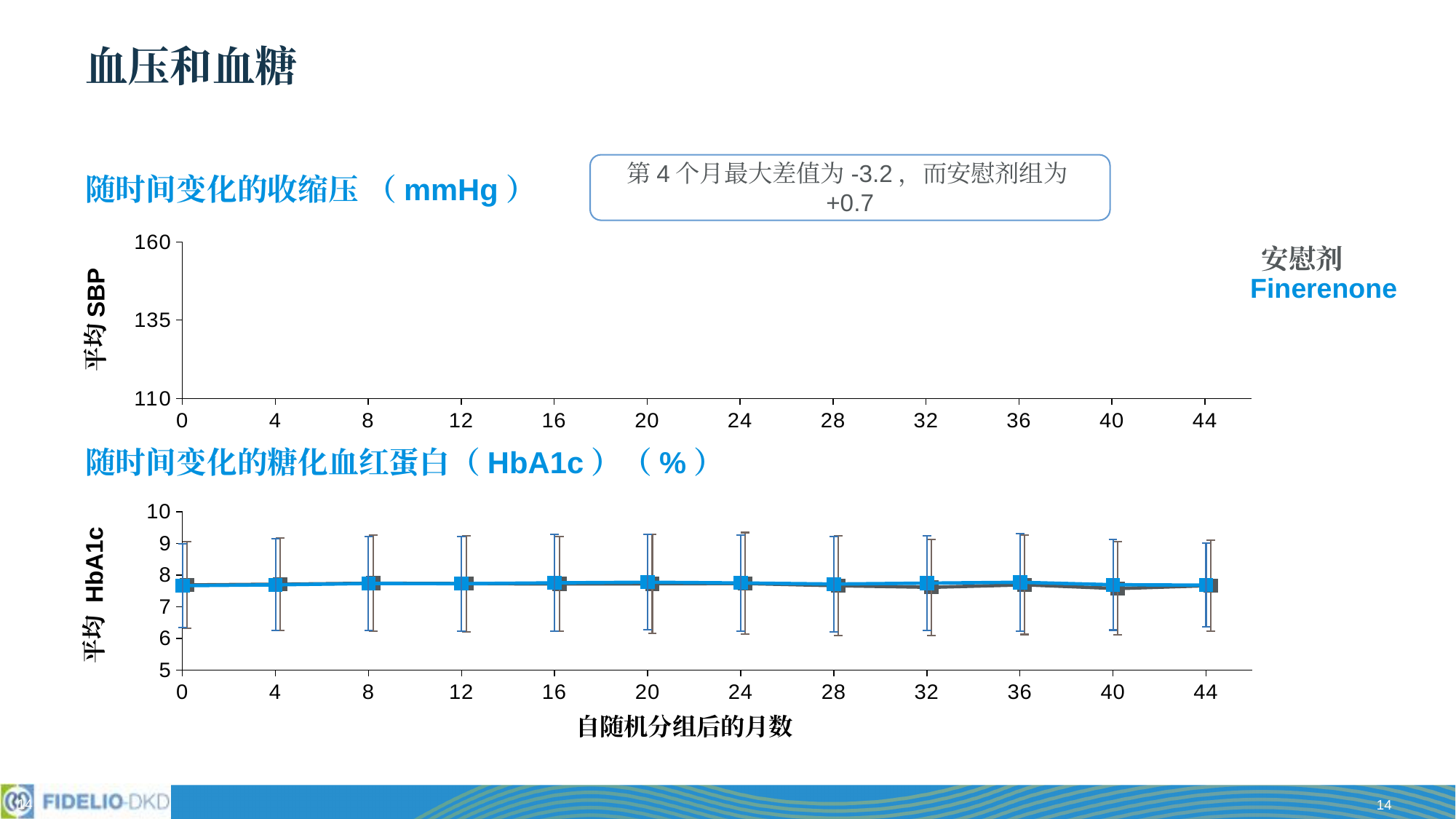
In the top SBP chart, what is the highest value shown on the y axis? 160 How many series does the legend list for the charts on this slide? 2 In the bottom HbA1c chart, do the mean HbA1c values rise, fall, or stay roughly flat from month 0 to month 44? stay roughly flat In the bottom HbA1c chart, is the Finerenone value at month 0 greater or less than 7? greater What kind of chart is the bottom chart (随时间变化的糖化血红蛋白)? line chart In the bottom HbA1c chart, what is the last month shown on the x axis? 44 In the bottom HbA1c chart, is the 安慰剂 value at month 44 greater or less than 9? less Which colour represents the Finerenone series in the legend? blue In the bottom HbA1c chart, how many time points are plotted along the x axis? 12 In the bottom HbA1c chart, is the Finerenone value at month 24 greater or less than 8? less